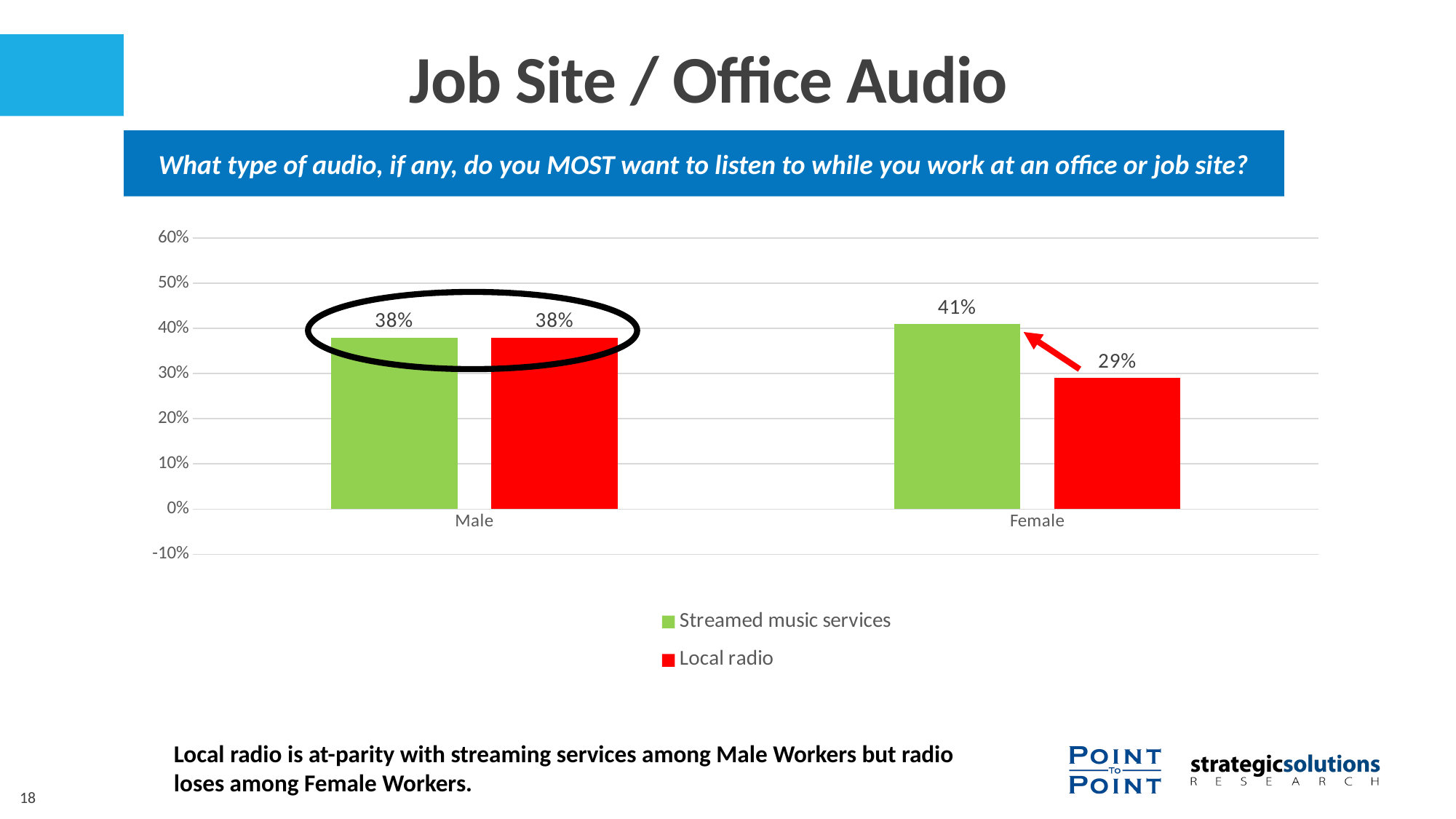
What is the difference between Streamed music services and Local radio among Female workers? 12 percentage points Among Female workers, which is larger: Streamed music services or Local radio? Streamed music services What is the value for Local radio among Female workers? 29% Which bar in the chart has the lowest value? Local radio, Female (29%) What is the value for Streamed music services among Female workers? 41% Which colour represents Local radio in the chart? Red How many categories are shown on the x axis? 2 Which bar in the chart has the highest value? Streamed music services, Female (41%) What kind of chart is shown on the slide? Bar chart What is the value for Local radio among Male workers? 38% What is the value for Streamed music services among Male workers? 38% How many series does the legend list? 2